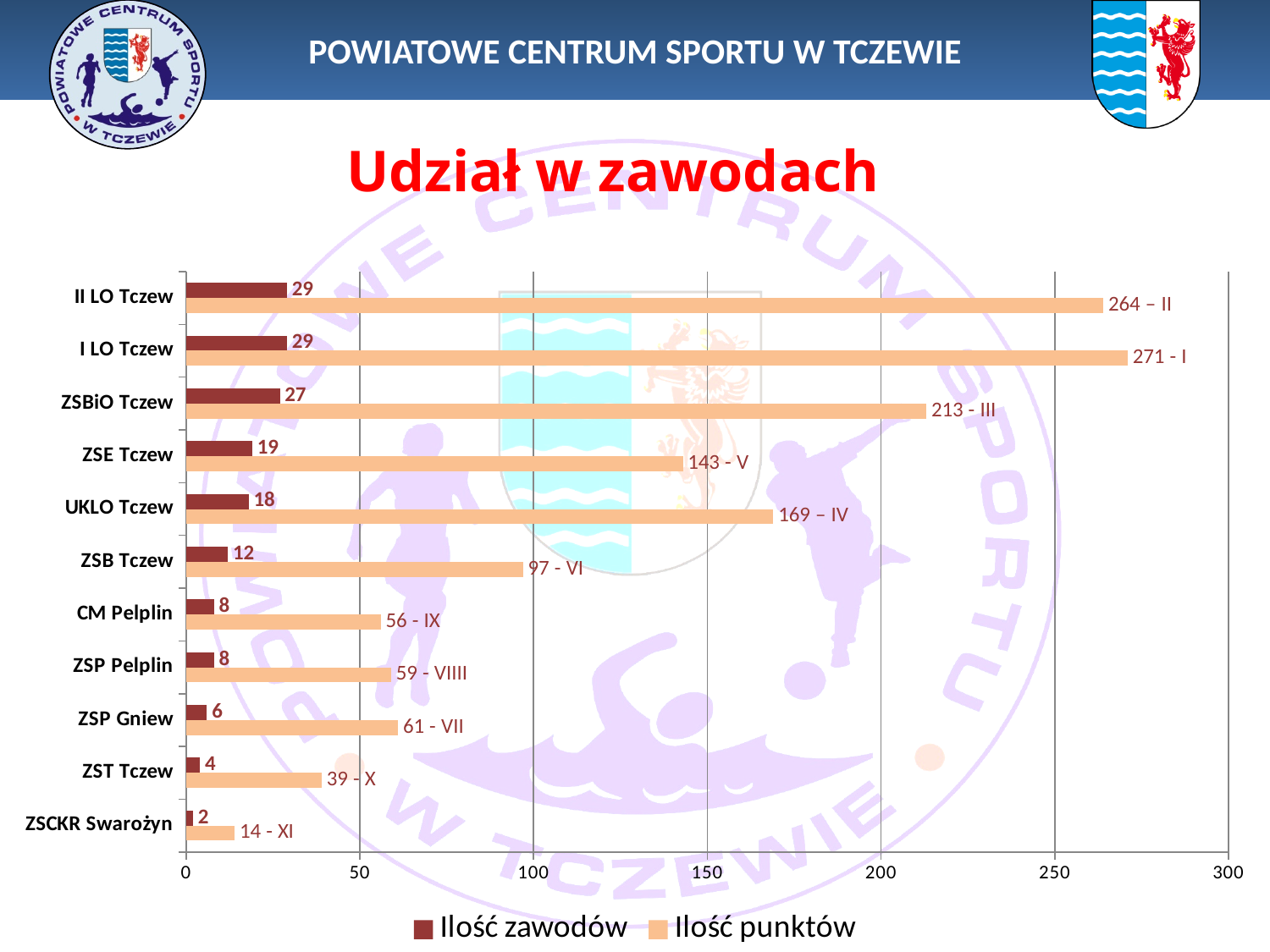
What is the value of Ilość zawodów for ZSCKR Swarożyn? 2 What is the data label on the Ilość punktów bar for I LO Tczew? 271 - I Is the Ilość punktów value for ZSB Tczew greater or less than 100? less What type of chart is shown on the slide? bar chart Which is larger: Ilość punktów for ZSE Tczew or for UKLO Tczew? UKLO Tczew What is the value of Ilość zawodów for ZSBiO Tczew? 27 How many series does the legend list? 2 What is the title of the chart? Udział w zawodach Which school has the highest Ilość punktów? I LO Tczew How many schools (categories) are shown on the chart? 11 What is the difference in Ilość punktów between I LO Tczew (271) and II LO Tczew (264)? 7 Which school has the lowest Ilość zawodów? ZSCKR Swarożyn